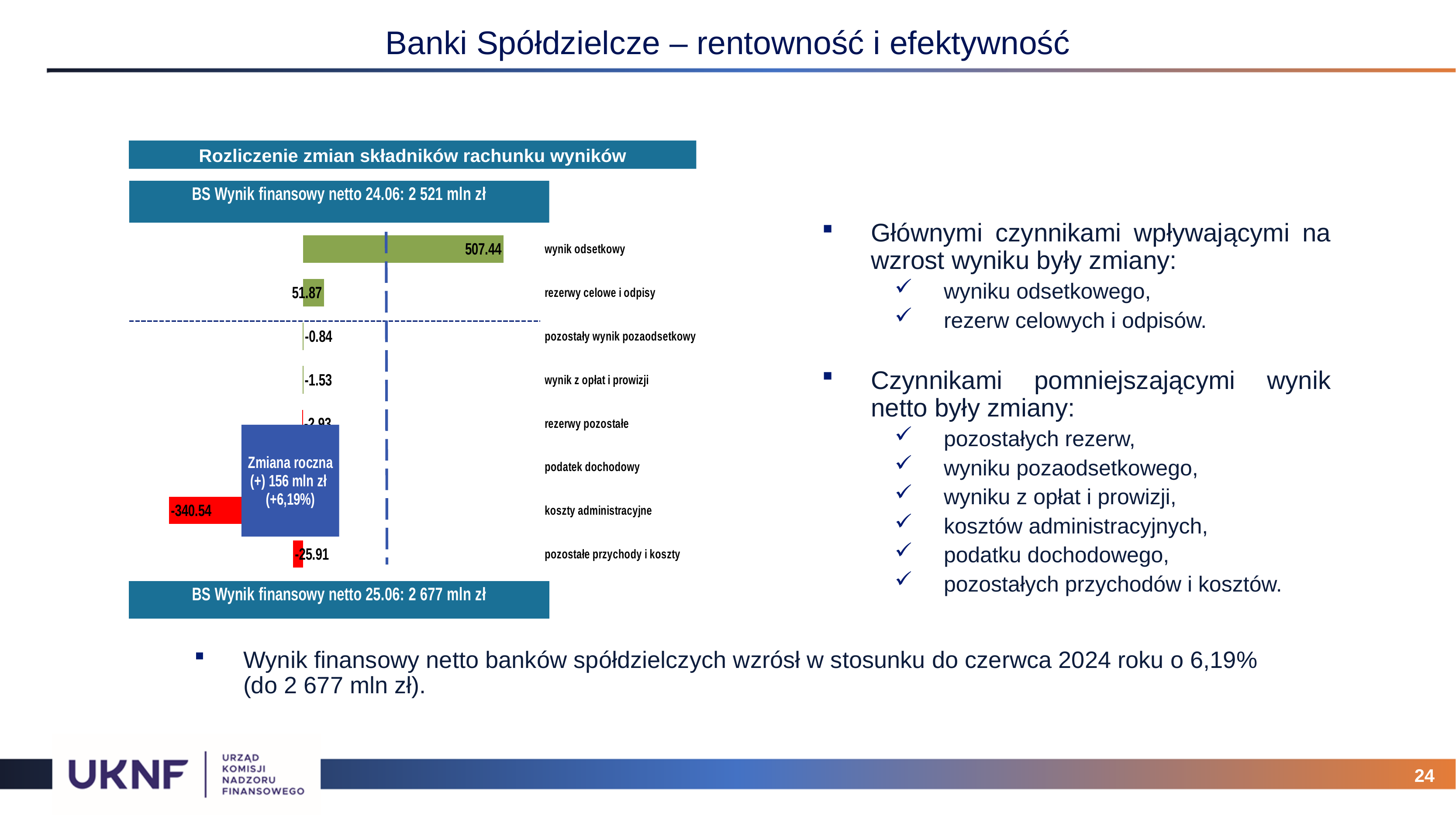
Which is larger in absolute terms, the value for koszty administracyjne or the value for pozostałe przychody i koszty? koszty administracyjne How many categories are labelled in the chart? 8 What is the value for wynik z opłat i prowizji in the chart? -1.53 Which category has the lowest value in the chart? koszty administracyjne What is the value for wynik odsetkowy in the chart? 507.44 What is the title of the chart? Rozliczenie zmian składników rachunku wyników Which category has the highest value in the chart? wynik odsetkowy What is the value for koszty administracyjne in the chart? -340.54 What is the difference between the values for wynik odsetkowy and rezerwy celowe i odpisy? 455.57 What is the value for pozostały wynik pozaodsetkowy in the chart? -0.84 What is the value for pozostałe przychody i koszty in the chart? -25.91 What is the value for rezerwy celowe i odpisy in the chart? 51.87